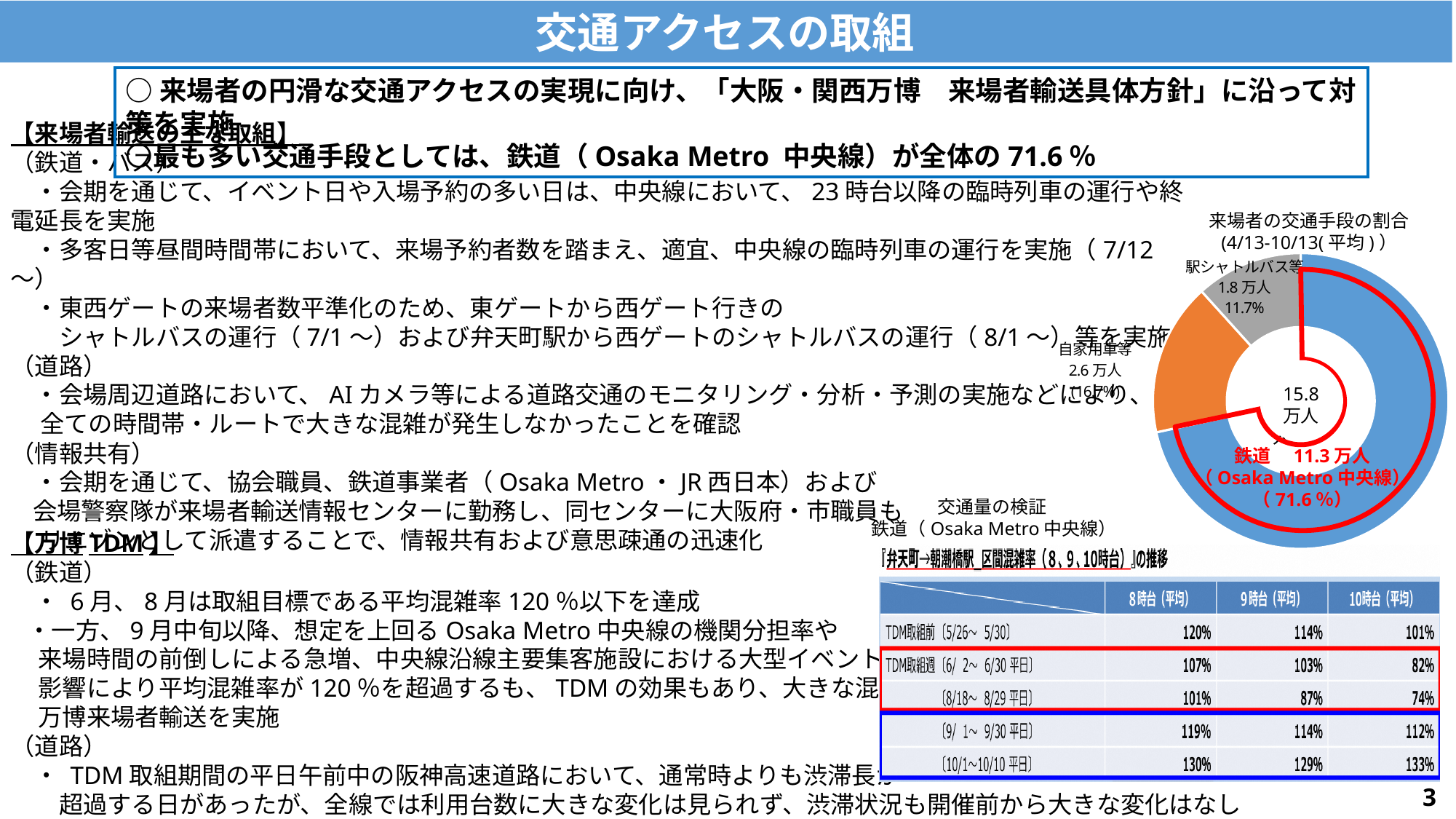
In the 来場者の交通手段の割合 chart, what share of visitors used 鉄道 (Osaka Metro 中央線)? 71.6% In the 来場者の交通手段の割合 chart, which transport mode has the smallest share? 駅シャトルバス等 In the 来場者の交通手段の割合 chart, how many people (万人) used 鉄道 (Osaka Metro 中央線)? 11.3万人 In the 来場者の交通手段の割合 chart, what is the total number of visitors shown in the centre? 15.8万人 In the 来場者の交通手段の割合 chart, how many people (万人) used 自家用車等? 2.6万人 What kind of chart is the 来場者の交通手段の割合 chart? pie chart (donut) In the 来場者の交通手段の割合 chart, what is the difference in 万人 between 鉄道 and 自家用車等? 8.7万人 In the 来場者の交通手段の割合 chart, how many transport mode categories are shown? 3 In the 来場者の交通手段の割合 chart, which is larger: 自家用車等 or 駅シャトルバス等? 自家用車等 In the 来場者の交通手段の割合 chart, how many people (万人) used 駅シャトルバス等? 1.8万人 In the 来場者の交通手段の割合 chart, which transport mode has the largest share? 鉄道 (Osaka Metro 中央線) In the 来場者の交通手段の割合 chart, what share of visitors used 駅シャトルバス等? 11.7%